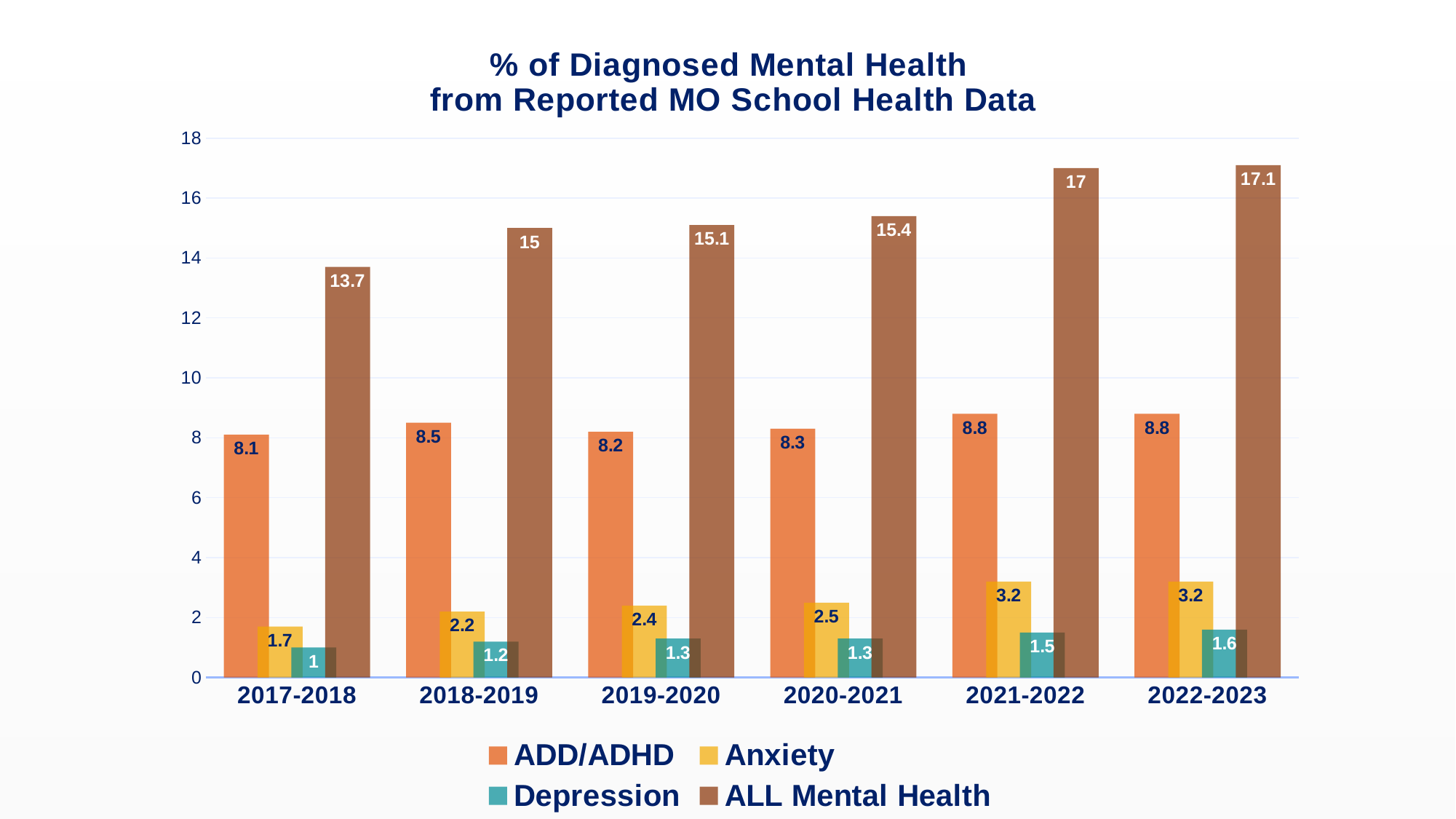
What kind of chart is shown on the slide? Bar chart What is the difference between the ALL Mental Health values for 2022-2023 and 2017-2018? 3.4 Do the ALL Mental Health values rise or fall from 2017-2018 to 2022-2023? Rise In which school year is the ALL Mental Health value highest? 2022-2023 What is the ADD/ADHD value for 2018-2019? 8.5 How many school years are shown on the x axis? 6 How many series does the legend list? 4 What is the ALL Mental Health value for 2022-2023? 17.1 In which school year is the Depression value lowest? 2017-2018 What is the Depression value for 2017-2018? 1 Which is larger, the Anxiety value for 2020-2021 or the Anxiety value for 2018-2019? 2020-2021 What is the Anxiety value for 2019-2020? 2.4